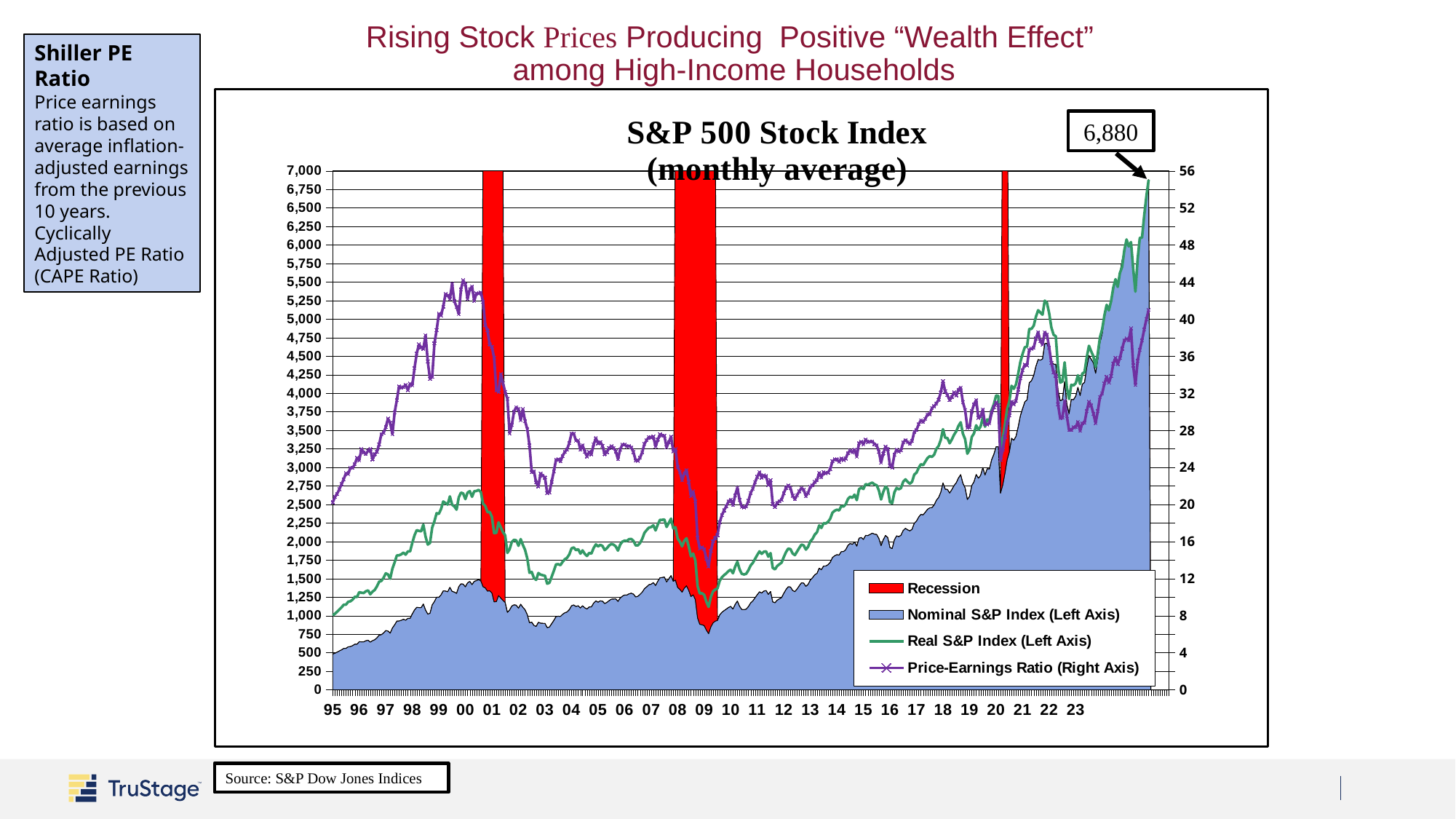
Which series is plotted on the right axis? Price-Earnings Ratio Is the Real S&P Index at the start of the chart in 95 greater or less than 1,500? less How many recession periods are shaded on the chart? 3 Does the Nominal S&P Index generally rise or fall from 95 to the end of the chart? rise Which is larger: the Nominal S&P Index in 2023 or in 2009? 2023 What is the title of the chart? S&P 500 Stock Index (monthly average) What value is labeled at the latest point of the S&P 500 index on the chart? 6,880 Which is larger: the Price-Earnings Ratio around 2000 or around 2009? around 2000 Is the Nominal S&P Index at its 2009 low greater or less than 1,000? less Is the Price-Earnings Ratio at its peak around 2000 greater or less than 40? greater How many entries does the chart legend list? 4